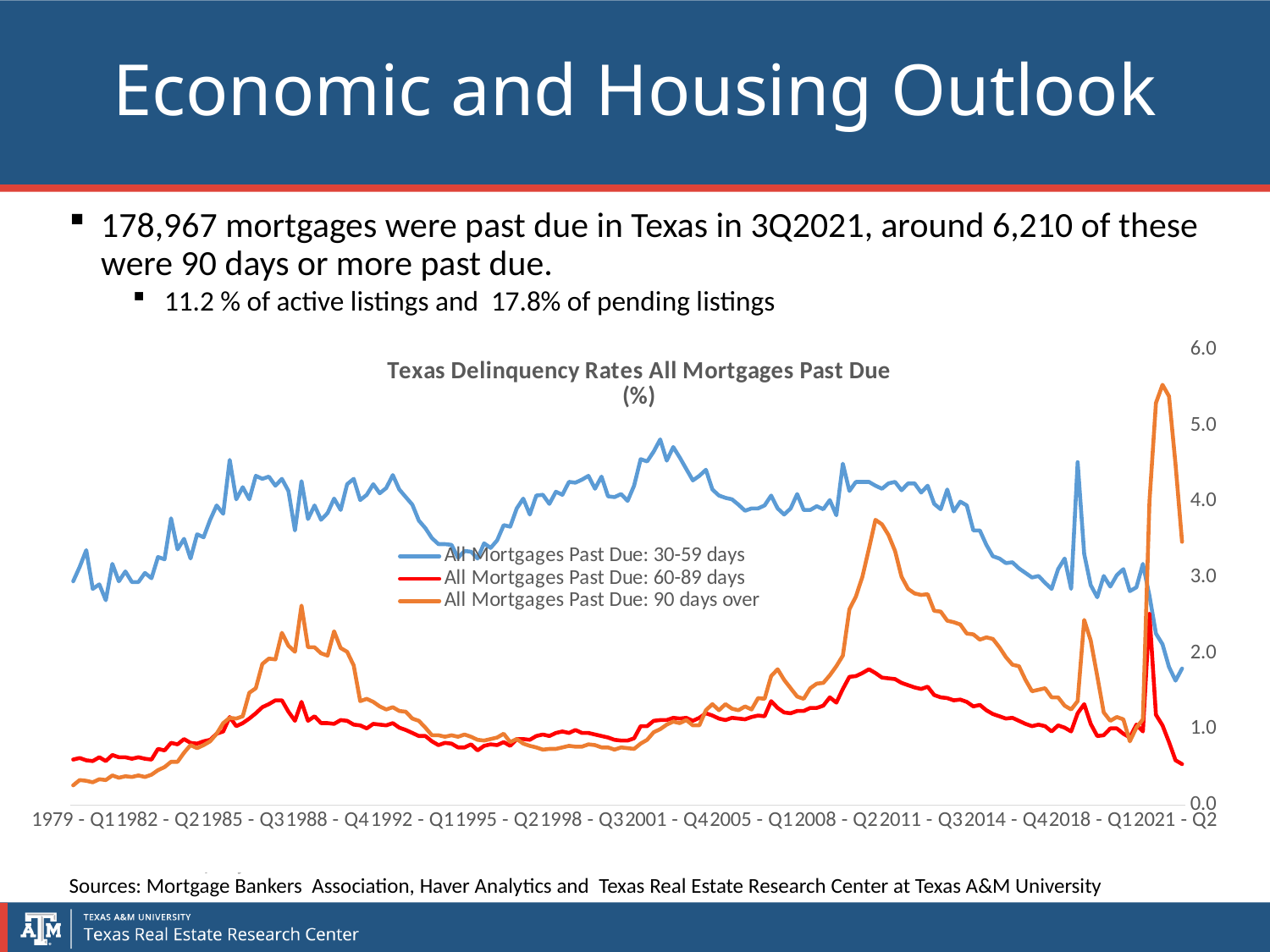
What is the title of the chart? Texas Delinquency Rates All Mortgages Past Due (%) Which series has the lowest value at 1979 - Q1? All Mortgages Past Due: 90 days over Is the value of 'All Mortgages Past Due: 30-59 days' at 1979 - Q1 greater or less than 2.0? greater Which series reaches the highest value anywhere on the chart? All Mortgages Past Due: 90 days over Is the value of 'All Mortgages Past Due: 60-89 days' at 2021 - Q2 greater or less than 1.0? less Which series is drawn in orange in the chart? All Mortgages Past Due: 90 days over Around 2001 - Q4, which series is higher: 'All Mortgages Past Due: 30-59 days' or 'All Mortgages Past Due: 60-89 days'? All Mortgages Past Due: 30-59 days Is the peak value of the 'All Mortgages Past Due: 90 days over' series greater or less than 5.0? greater What kind of chart is shown on the slide? line chart What is the highest value shown on the vertical axis? 6.0 How many series does the chart's legend list? 3 Does the 'All Mortgages Past Due: 30-59 days' series rise or fall between 2011 - Q3 and 2014 - Q4? fall